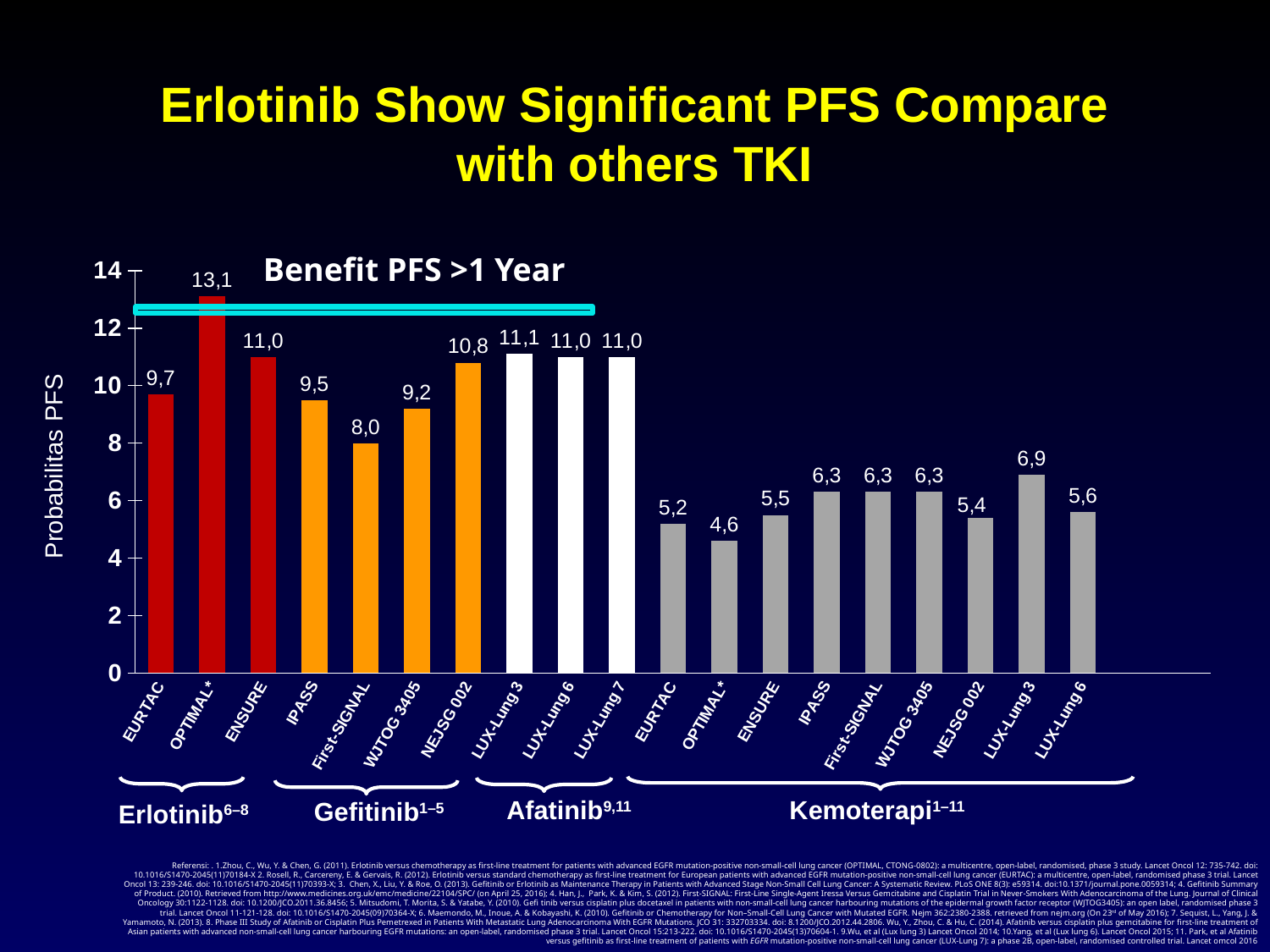
What is the PFS value for First-SIGNAL in the Gefitinib group? 8,0 What is the PFS value for OPTIMAL* in the Kemoterapi group? 4,6 How many bars are plotted on the chart? 19 Which is larger: the PFS for NEJSG 002 in the Gefitinib group or for IPASS in the Gefitinib group? NEJSG 002 What is the PFS value for LUX-Lung 3 in the Afatinib group? 11,1 Is the PFS value for LUX-Lung 3 in the Kemoterapi group greater or less than 8? less What is the difference between the PFS for EURTAC in the Erlotinib group and EURTAC in the Kemoterapi group? 4,5 What is the label of the y-axis? Probabilitas PFS What is the PFS value for OPTIMAL* in the Erlotinib group? 13,1 Which bar has the lowest PFS value on the chart? OPTIMAL* (Kemoterapi) What type of chart is shown on the slide? Bar chart Which bar has the highest PFS value on the chart? OPTIMAL* (Erlotinib)